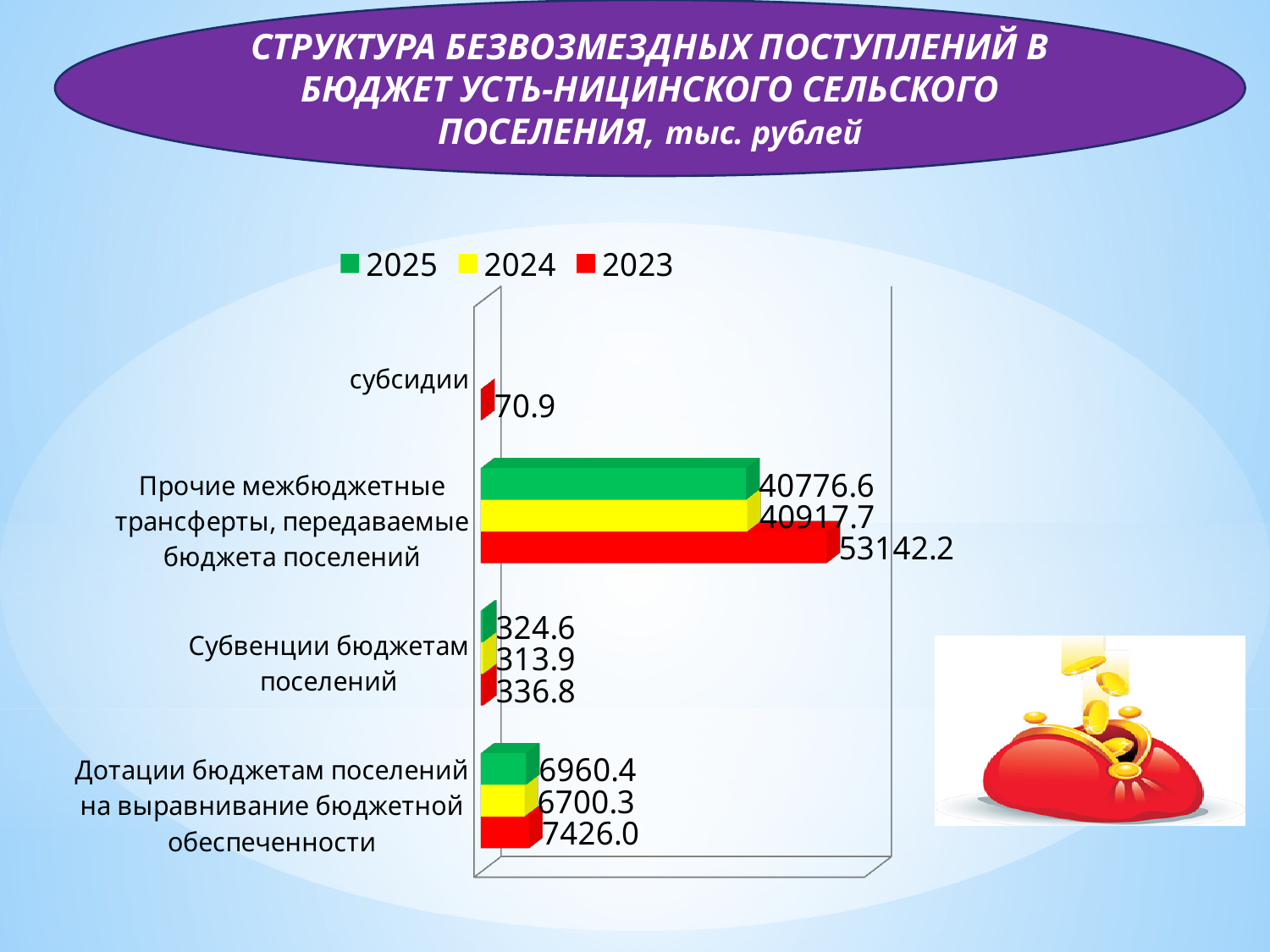
What kind of chart is shown on the slide? Bar chart What is the difference between the 2023 and 2024 values for Прочие межбюджетные трансферты, передаваемые бюджета поселений? 12224.5 Which category has the highest 2023 value? Прочие межбюджетные трансферты, передаваемые бюджета поселений What is the 2024 value for Субвенции бюджетам поселений? 313.9 For Дотации бюджетам поселений на выравнивание бюджетной обеспеченности, which is larger: the 2025 value or the 2024 value? 2025 Which category has the lowest 2023 value? субсидии What is the 2023 value for субсидии? 70.9 Which colour represents the 2024 series in the legend? Yellow How many categories are shown on the chart? 4 What is the 2025 value for Прочие межбюджетные трансферты, передаваемые бюджета поселений? 40776.6 What is the 2023 value for Дотации бюджетам поселений на выравнивание бюджетной обеспеченности? 7426.0 How many series does the legend list? 3